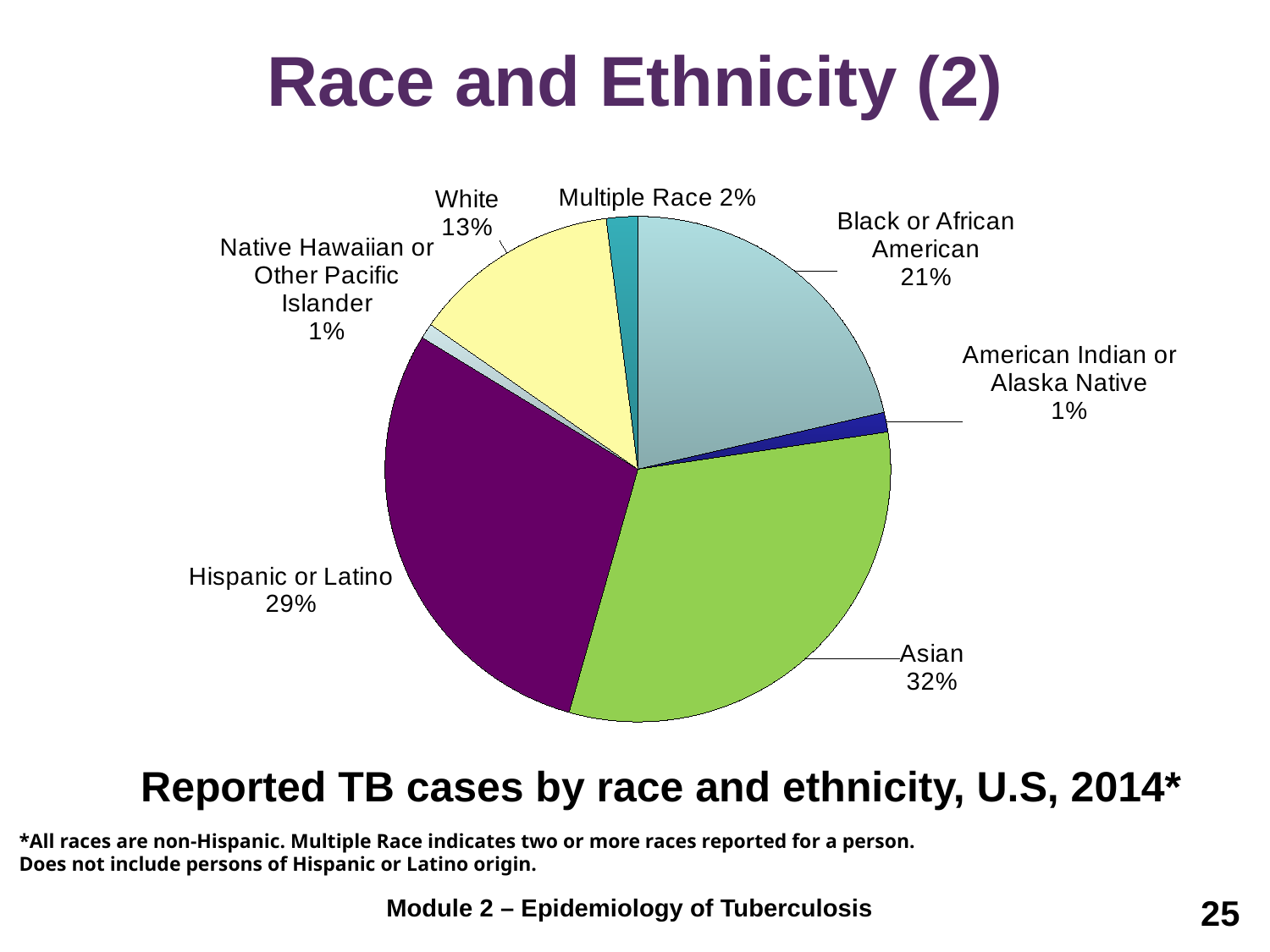
What share of reported TB cases is White? 13% What is the title of the chart? Reported TB cases by race and ethnicity, U.S, 2014* Which is larger, the share for Hispanic or Latino or the share for Black or African American? Hispanic or Latino Which race or ethnicity group has the largest share of reported TB cases? Asian What is the difference in percentage points between the Black or African American and White shares? 8 What kind of chart is shown on the slide? Pie chart What share of reported TB cases is Hispanic or Latino? 29% What share of reported TB cases is Multiple Race? 2% How many race and ethnicity categories are shown in the pie chart? 7 What share of reported TB cases is Black or African American? 21% What is the difference in percentage points between the Asian and Hispanic or Latino shares? 3 What share of reported TB cases is Asian? 32%